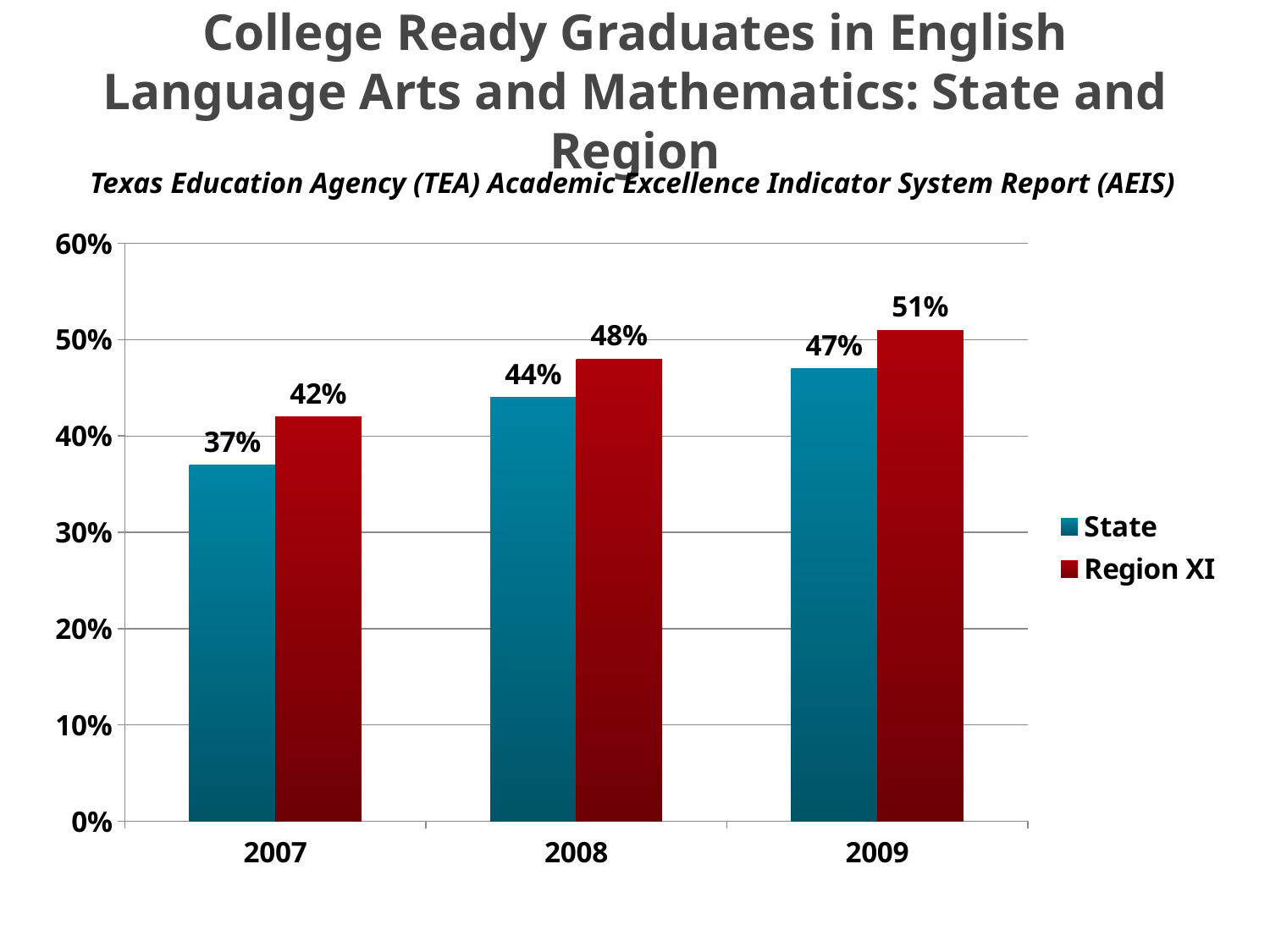
What is the Region XI value for 2009? 51% Which is larger in 2009, the State value or the Region XI value? Region XI What is the State value for 2007? 37% What kind of chart is shown on the slide? Bar chart In which year is the Region XI value lowest? 2007 How many series does the legend list? 2 Do the State values rise or fall from 2007 to 2009? Rise What is the difference between the Region XI and State values in 2008? 4% Is the Region XI value for 2009 greater or less than 50%? greater How many years are shown on the x axis? 3 In which year is the State value highest? 2009 What is the Region XI value for 2008? 48%